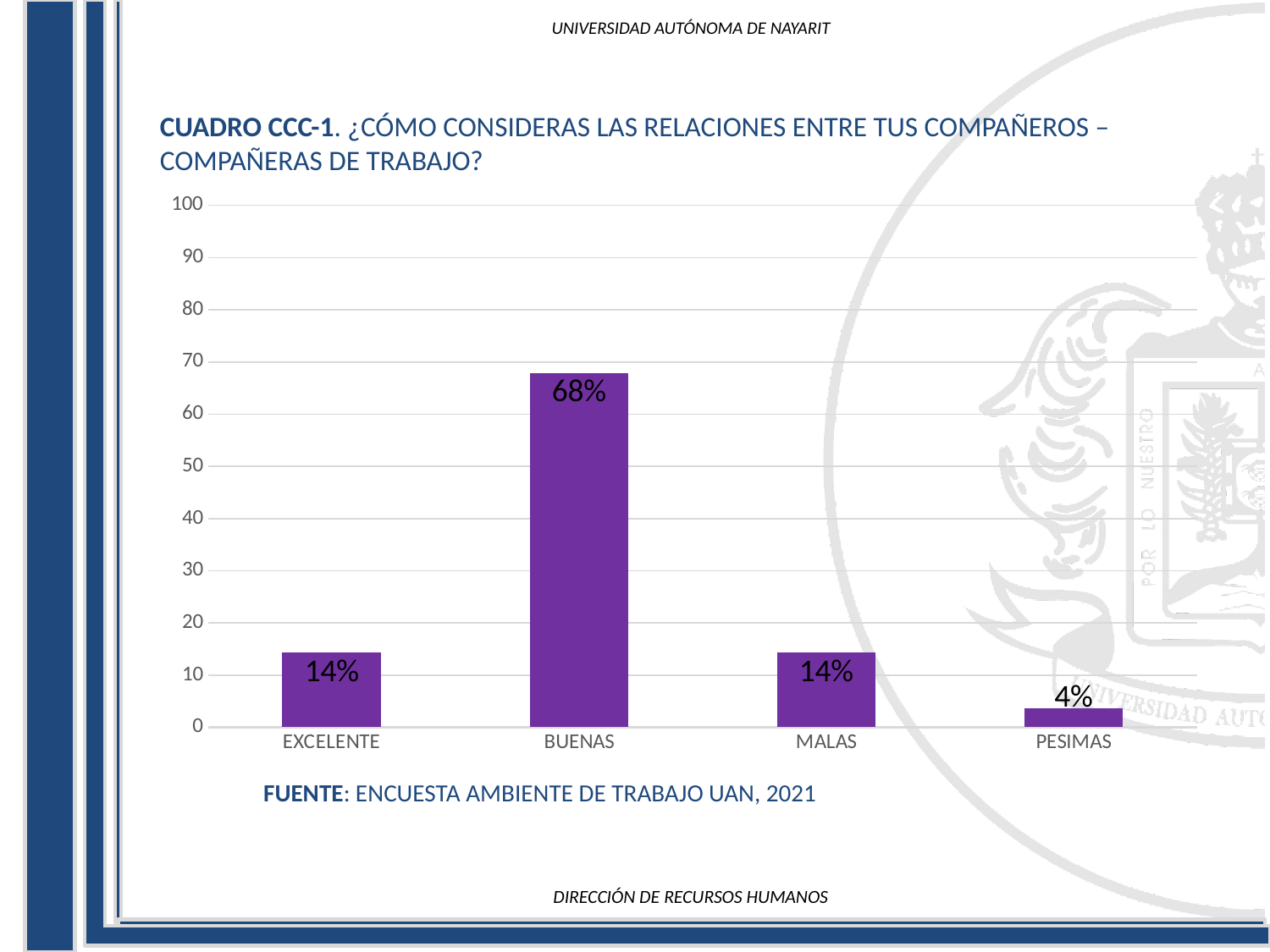
What is the value for PESIMAS? 4% Which is larger, the value for MALAS or the value for PESIMAS? MALAS Which category has the highest value? BUENAS What is the value for EXCELENTE? 14% What kind of chart is shown on the slide? bar chart What is the source cited below the chart? ENCUESTA AMBIENTE DE TRABAJO UAN, 2021 How many categories are shown on the x axis? 4 Which category has the lowest value? PESIMAS Is the value for BUENAS greater or less than 60? greater What is the highest value shown on the y axis? 100 What is the value for BUENAS? 68% What is the difference between the values for BUENAS and MALAS? 54%